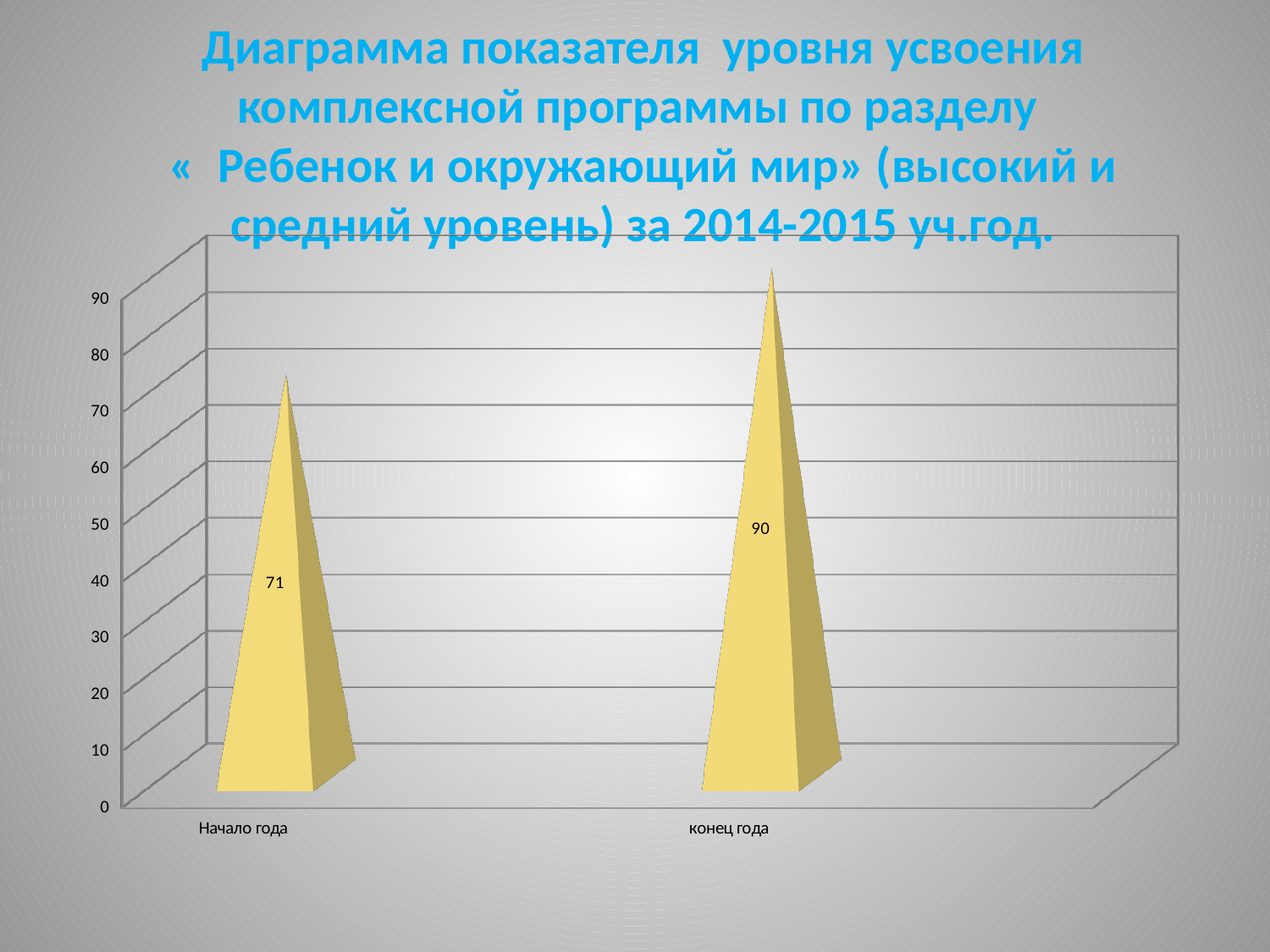
Which is larger, the value for "Начало года" or the value for "конец года"? конец года Is the value for "конец года" greater or less than 80? greater What is the highest tick value shown on the vertical axis? 90 What is the difference between the values for "конец года" and "Начало года"? 19 Is the value for "Начало года" greater or less than 80? less Which category has the lowest value? Начало года Which category has the highest value? конец года What is the value for "конец года"? 90 What is the value for "Начало года"? 71 What kind of chart is shown on the slide? bar chart Do the values rise or fall from "Начало года" to "конец года"? rise How many categories are shown on the x axis? 2